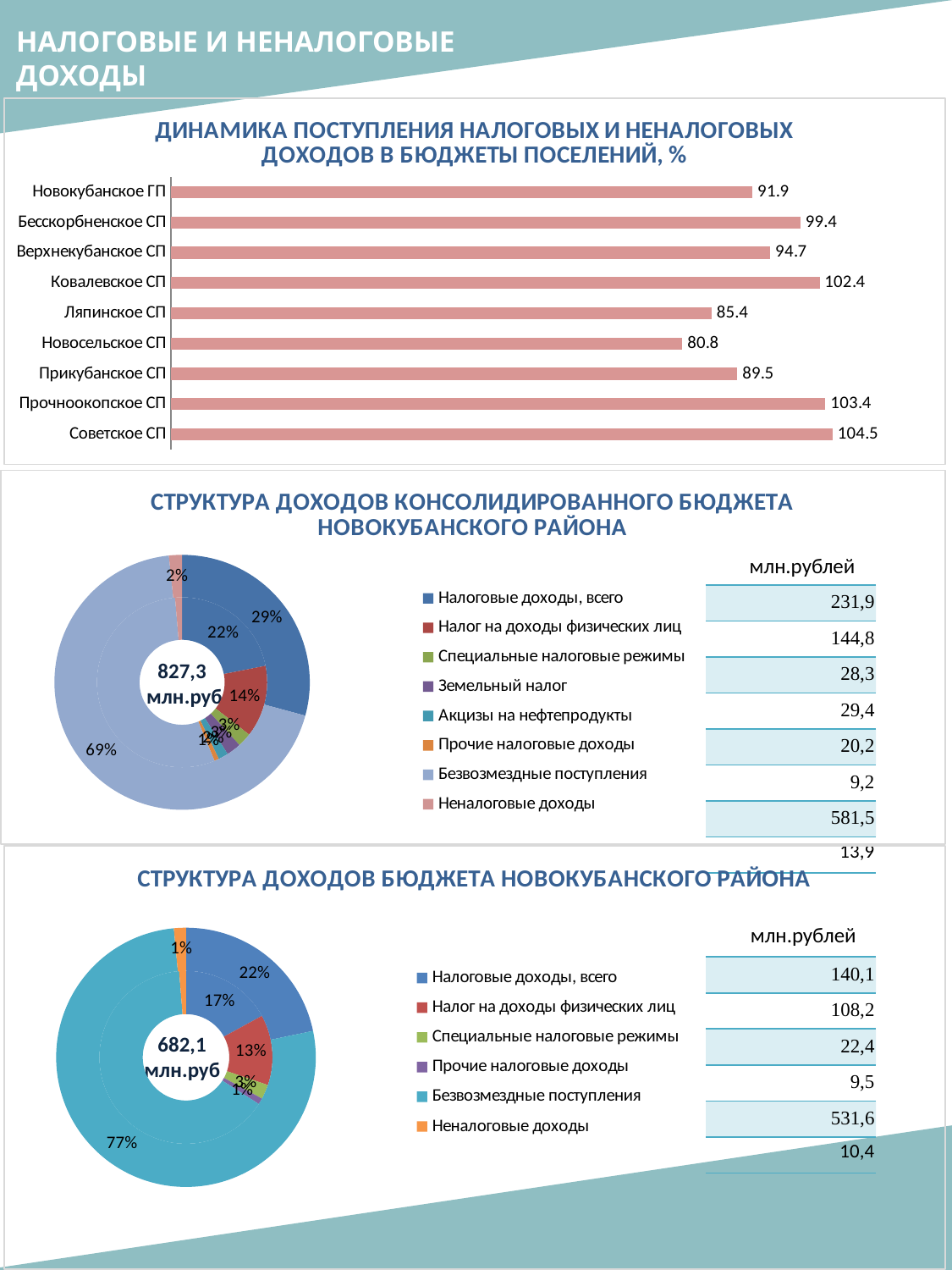
In the chart 'Структура доходов консолидированного бюджета Новокубанского района', what share of the outer ring is Безвозмездные поступления? 69% What type of chart is 'Динамика поступления налоговых и неналоговых доходов в бюджеты поселений, %'? bar chart In the chart 'Структура доходов консолидированного бюджета Новокубанского района', what is the value in млн.рублей for Налог на доходы физических лиц? 144,8 How many series does the legend list in the chart 'Структура доходов консолидированного бюджета Новокубанского района'? 8 In the bar chart 'Динамика поступления налоговых и неналоговых доходов в бюджеты поселений, %', which settlement has the lowest value? Новосельское СП How many settlements are shown in the bar chart 'Динамика поступления налоговых и неналоговых доходов в бюджеты поселений, %'? 9 In the bar chart 'Динамика поступления налоговых и неналоговых доходов в бюджеты поселений, %', what is the difference between Прочноокопское СП and Ляпинское СП? 18.0 In the bar chart 'Динамика поступления налоговых и неналоговых доходов в бюджеты поселений, %', which is larger: Бесскорбненское СП or Верхнекубанское СП? Бесскорбненское СП In the bar chart 'Динамика поступления налоговых и неналоговых доходов в бюджеты поселений, %', what is the value for Ковалевское СП? 102.4 In the chart 'Структура доходов бюджета Новокубанского района', what share of the outer ring is Безвозмездные поступления? 77% In the chart 'Структура доходов бюджета Новокубанского района', what total is shown in the centre of the doughnut? 682,1 млн.руб In the bar chart 'Динамика поступления налоговых и неналоговых доходов в бюджеты поселений, %', which settlement has the highest value? Советское СП